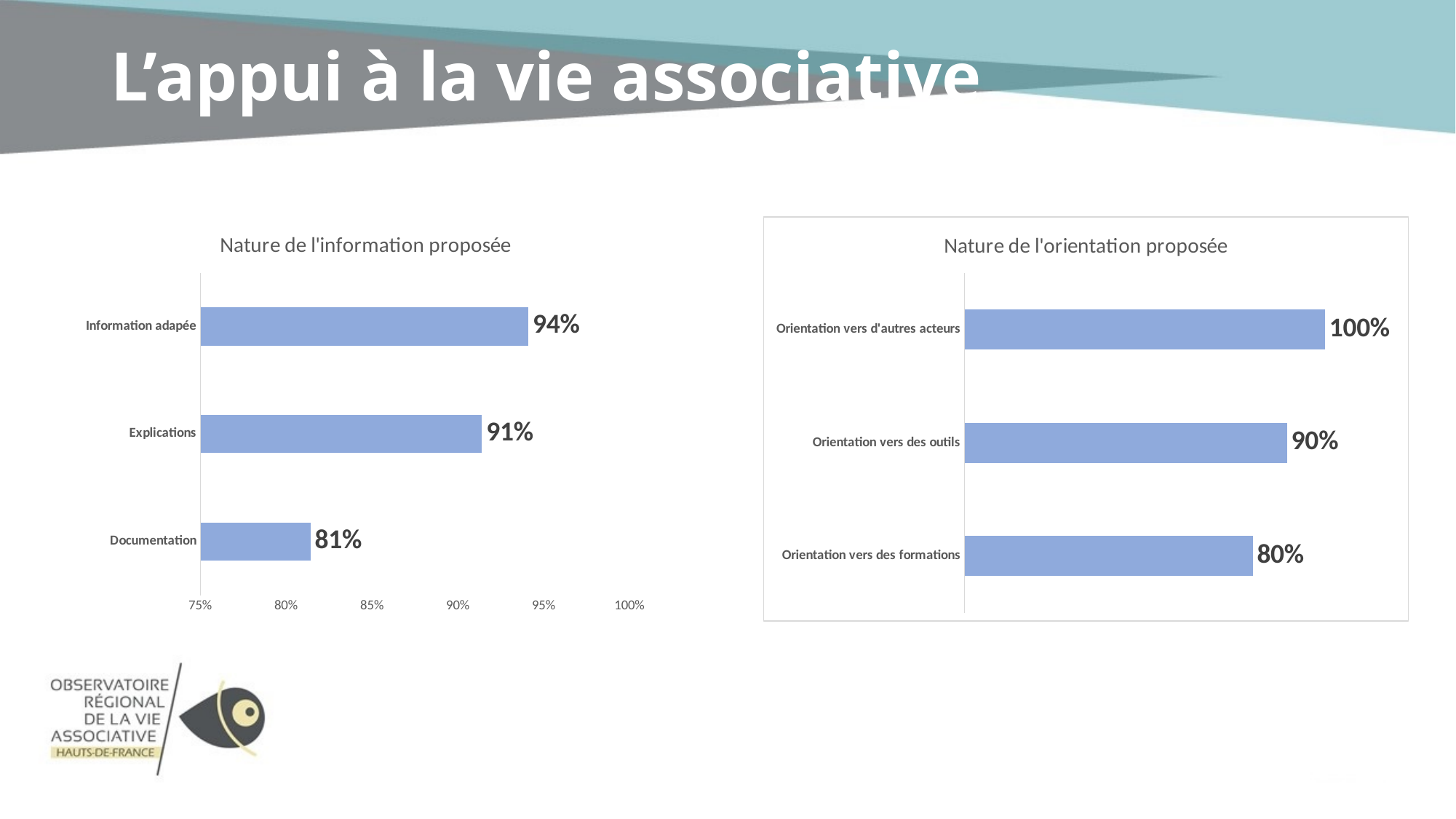
In the chart titled 'Nature de l'information proposée', how many categories are shown? 3 In the chart titled 'Nature de l'information proposée', is the value for Explications greater or less than 90%? greater In the chart titled 'Nature de l'orientation proposée', which category has the highest value? Orientation vers d'autres acteurs In the chart titled 'Nature de l'information proposée', which category has the lowest value? Documentation In the chart titled 'Nature de l'information proposée', what is the value for Information adapée? 94% What kind of chart is the chart titled 'Nature de l'orientation proposée'? Bar chart How many charts are on the slide? 2 In the chart titled 'Nature de l'orientation proposée', which is larger: Orientation vers des outils or Orientation vers des formations? Orientation vers des outils In the chart titled 'Nature de l'orientation proposée', what is the value for Orientation vers des outils? 90% In the chart titled 'Nature de l'information proposée', what is the value for Documentation? 81% In the chart titled 'Nature de l'orientation proposée', what is the difference between Orientation vers d'autres acteurs and Orientation vers des formations? 20% In the chart titled 'Nature de l'information proposée', what is the difference between Information adapée and Explications? 3%